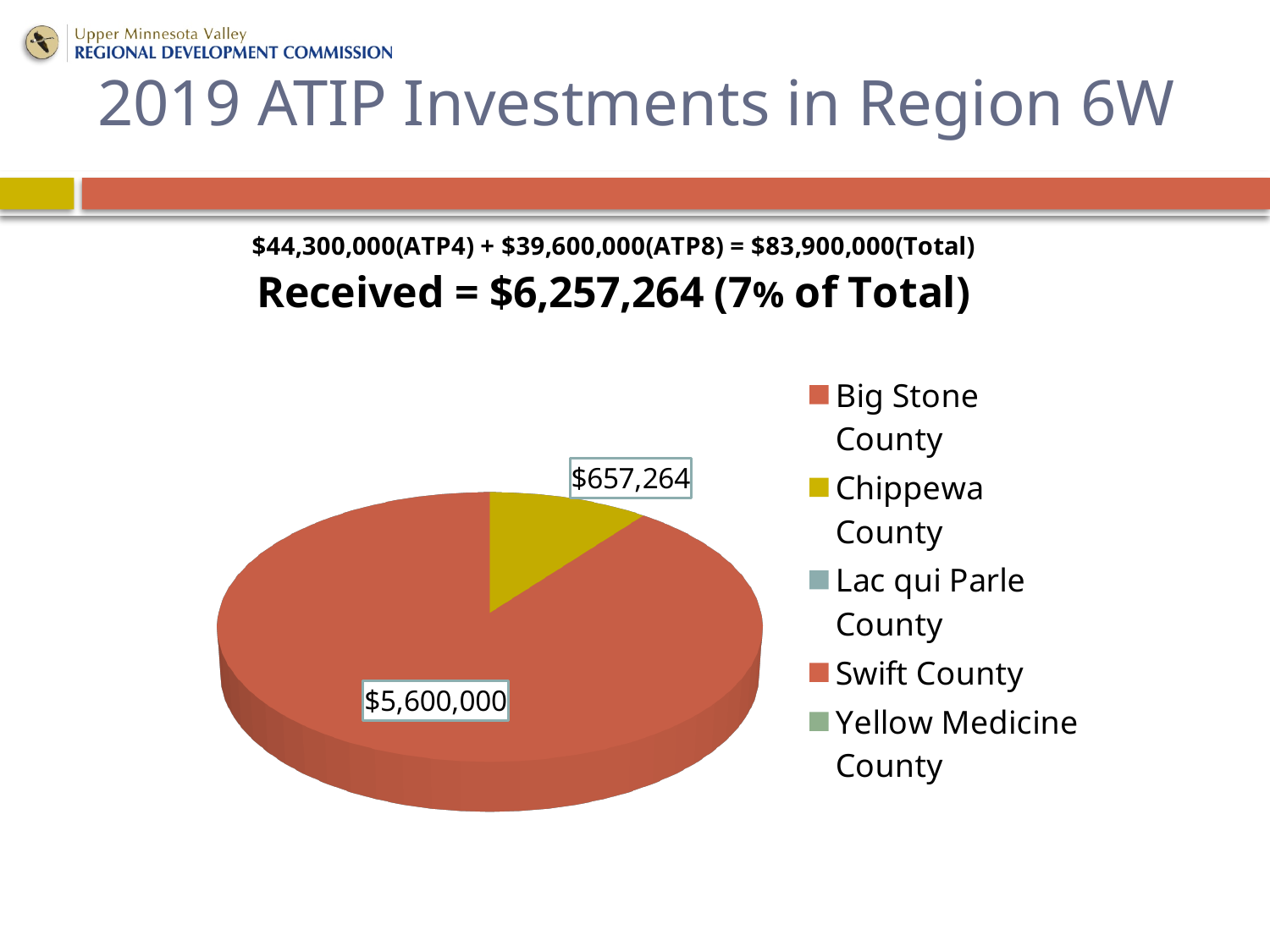
What is the total of the two labelled slice values in the pie chart? $6,257,264 What is the difference between the two labelled slice values, $5,600,000 and $657,264? $4,942,736 What share of the pie does the Chippewa County slice ($657,264 of $6,257,264) represent, to one decimal place? 10.5% What is the title of the slide containing the pie chart? 2019 ATIP Investments in Region 6W Of the two labelled slices, which county has the smaller value? Chippewa County Which county does the yellow slice of the pie chart represent? Chippewa County Which is larger: the value for Chippewa County or the value of the large red slice? the large red slice How many entries does the legend of the pie chart list? 5 What value is labelled on the yellow slice (Chippewa County) of the pie chart? $657,264 What kind of chart is shown on the slide? pie chart What value is labelled on the largest slice of the pie chart? $5,600,000 How many slices of the pie chart carry a data label? 2